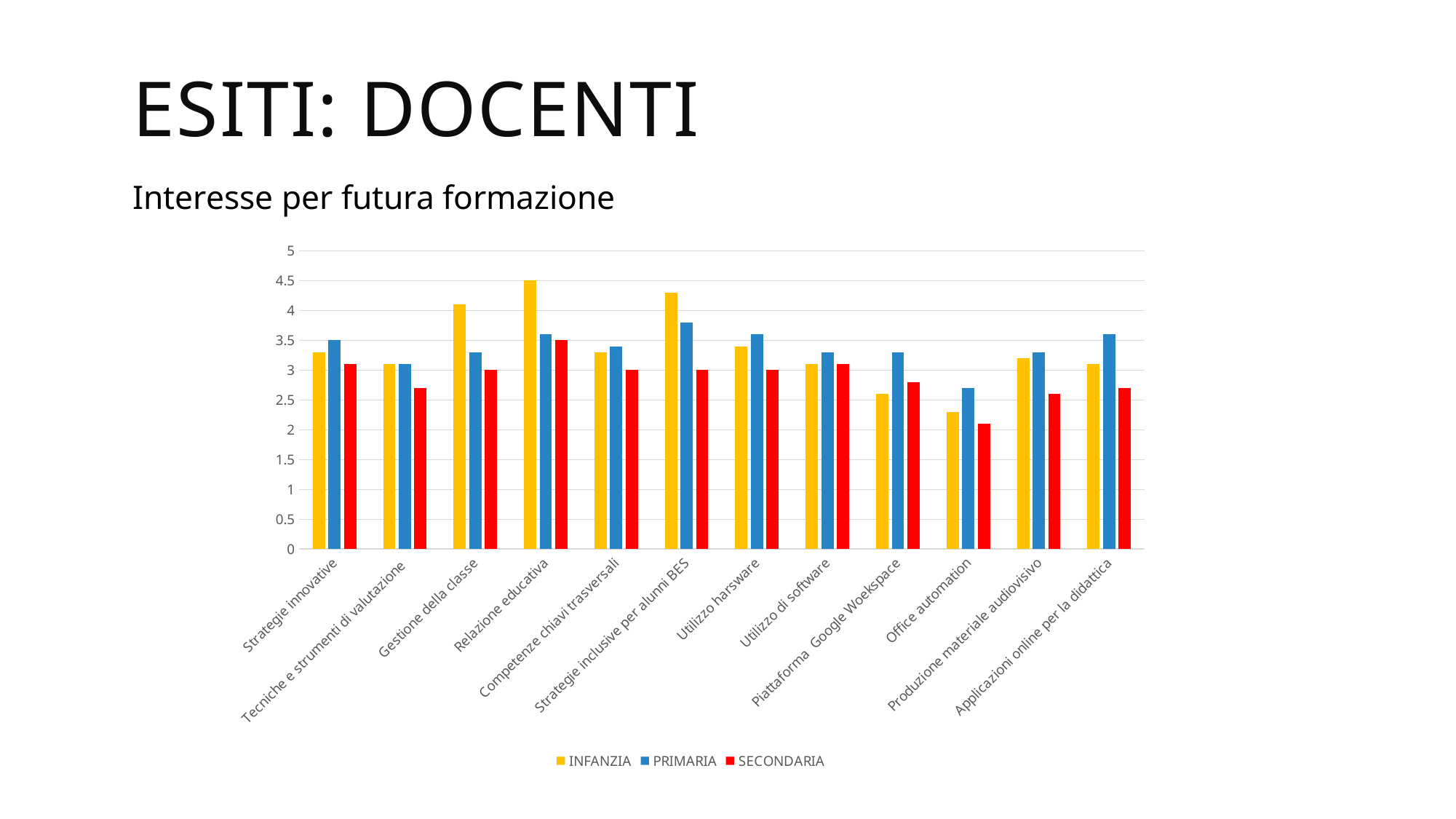
What kind of chart is shown on the slide? bar chart Is the INFANZIA value for Office automation greater or less than 2.5? less For which category is the SECONDARIA value lowest? Office automation How many categories are shown on the x axis? 12 Is the SECONDARIA value for Tecniche e strumenti di valutazione greater or less than 3? less Is the PRIMARIA value for Applicazioni online per la didattica greater or less than 3? greater What is the subtitle shown above the chart? Interesse per futura formazione Which colour represents the SECONDARIA series in the legend? red For Gestione della classe, which is larger: the INFANZIA value or the PRIMARIA value? INFANZIA How many series does the legend list? 3 For which category is the INFANZIA value highest? Relazione educativa